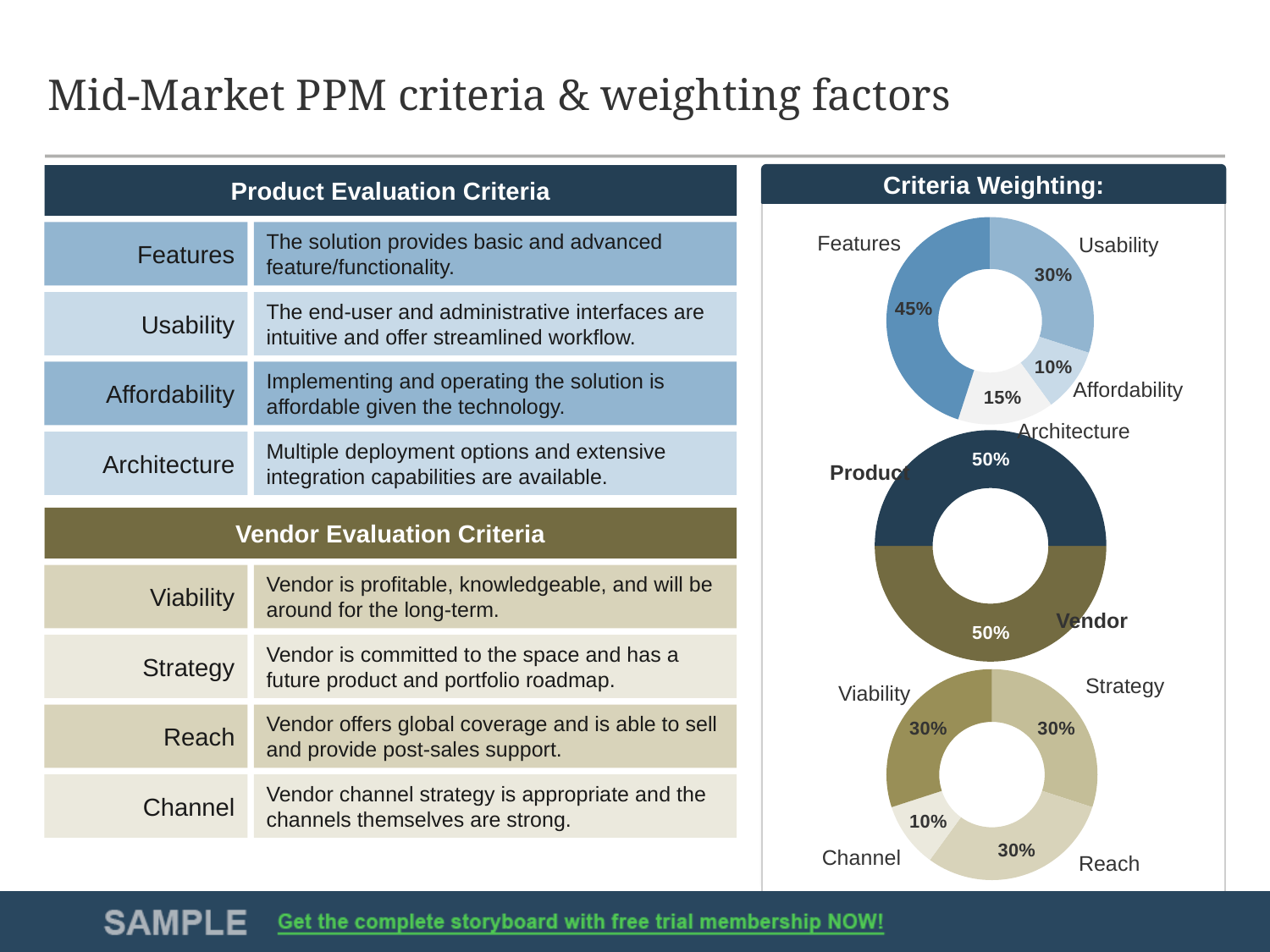
In the top donut chart, which criterion has the highest weighting? Features In the middle donut chart, what is the weighting for Vendor? 50% In the top donut chart, which has a larger weighting, Architecture or Affordability? Architecture In the top donut chart, what is the weighting for Features? 45% How many categories are shown in the bottom donut chart? 4 How many segments does the middle donut chart have? 2 In the bottom donut chart, which criterion has the lowest weighting? Channel In the top donut chart, what is the weighting for Affordability? 10% In the top donut chart, what is the difference between the weightings for Features and Usability? 15% What type of chart is used to show the criteria weighting? Donut chart In the bottom donut chart, what is the weighting for Channel? 10% In the top donut chart, which criterion has the lowest weighting? Affordability